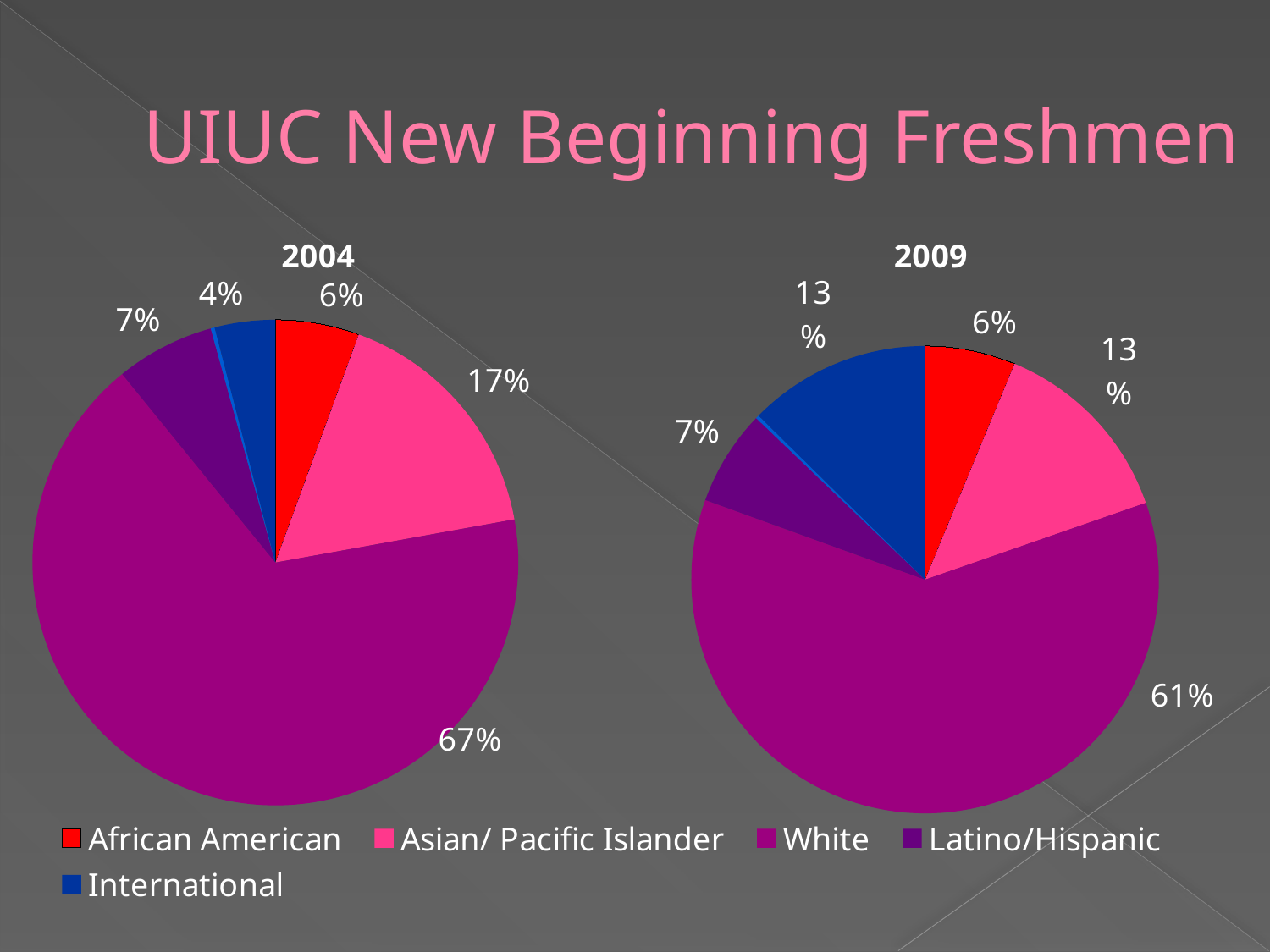
In the 2004 pie chart, what percentage is shown for International? 4% How many categories does the legend list? 5 In the 2004 pie chart, which category has the smallest labelled share? International In the 2009 pie chart, what percentage is shown for Latino/Hispanic? 7% In the 2004 pie chart, what percentage is shown for White? 67% Which is larger: the International share in 2004 or the International share in 2009? 2009 What is the difference between the White share in 2004 and the White share in 2009? 6% In the 2009 pie chart, what percentage is shown for International? 13% In the 2004 pie chart, which category has the largest share? White What type of charts are shown on the slide? Pie charts In the 2009 pie chart, what percentage is shown for White? 61% In the 2004 pie chart, what percentage is shown for Asian/ Pacific Islander? 17%